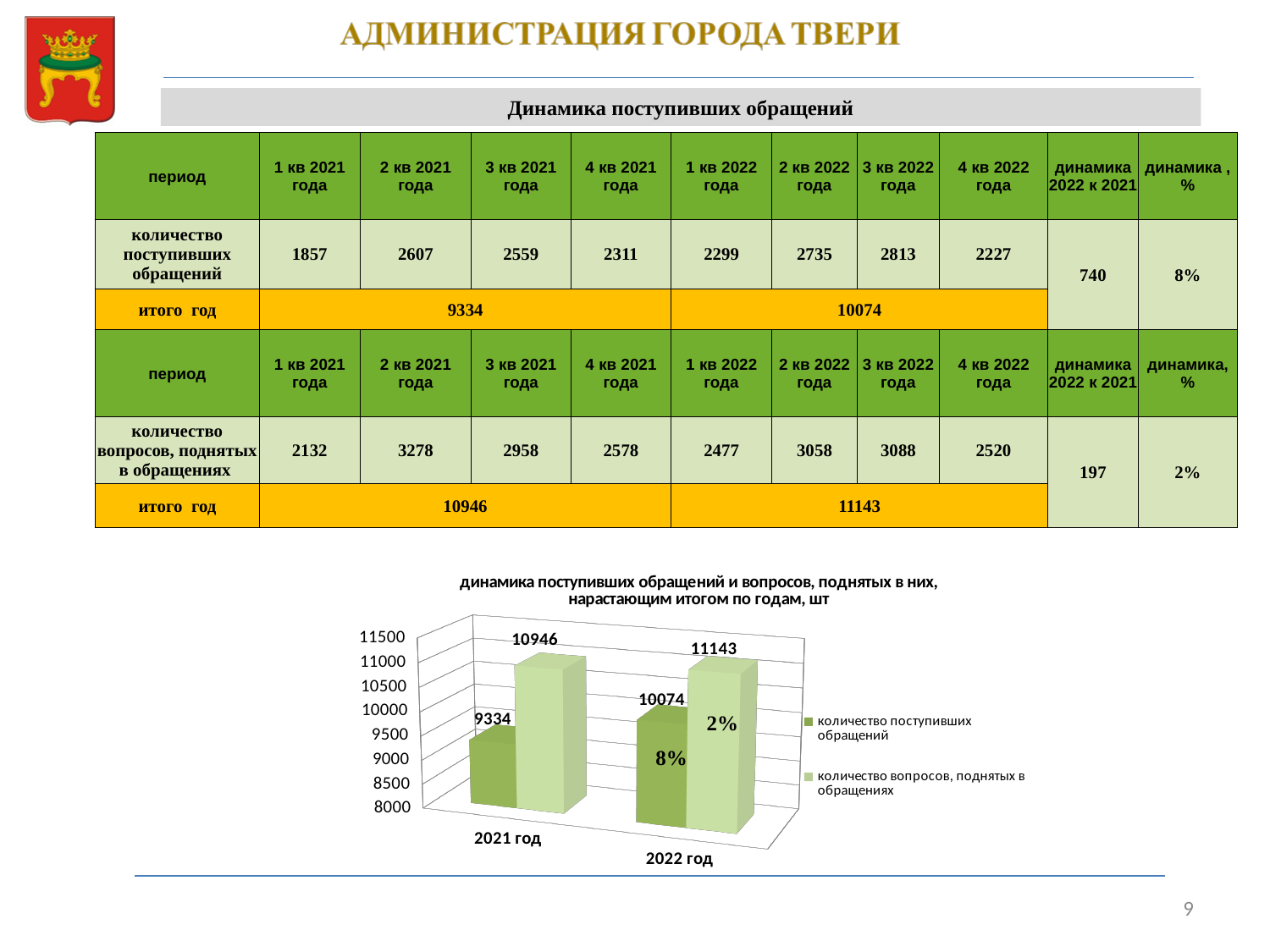
What is the value of 'количество вопросов, поднятых в обращениях' for 2021 год in the chart? 10946 What type of chart is shown on the slide? bar chart In the chart, which is larger for 2022 год: 'количество поступивших обращений' or 'количество вопросов, поднятых в обращениях'? количество вопросов, поднятых в обращениях What is the value of 'количество вопросов, поднятых в обращениях' for 2022 год in the chart? 11143 By how much did 'количество поступивших обращений' increase from 2021 год to 2022 год according to the chart? 740 Does 'количество поступивших обращений' rise or fall from 2021 год to 2022 год in the chart? rise What is the value of 'количество поступивших обращений' for 2021 год in the chart? 9334 How many series does the chart legend list? 2 What percentage label is shown next to the 2022 год bar for 'количество поступивших обращений'? 8% What is the value of 'количество поступивших обращений' for 2022 год in the chart? 10074 How many year categories are shown on the chart's x axis? 2 By how much did 'количество вопросов, поднятых в обращениях' increase from 2021 год to 2022 год according to the chart? 197